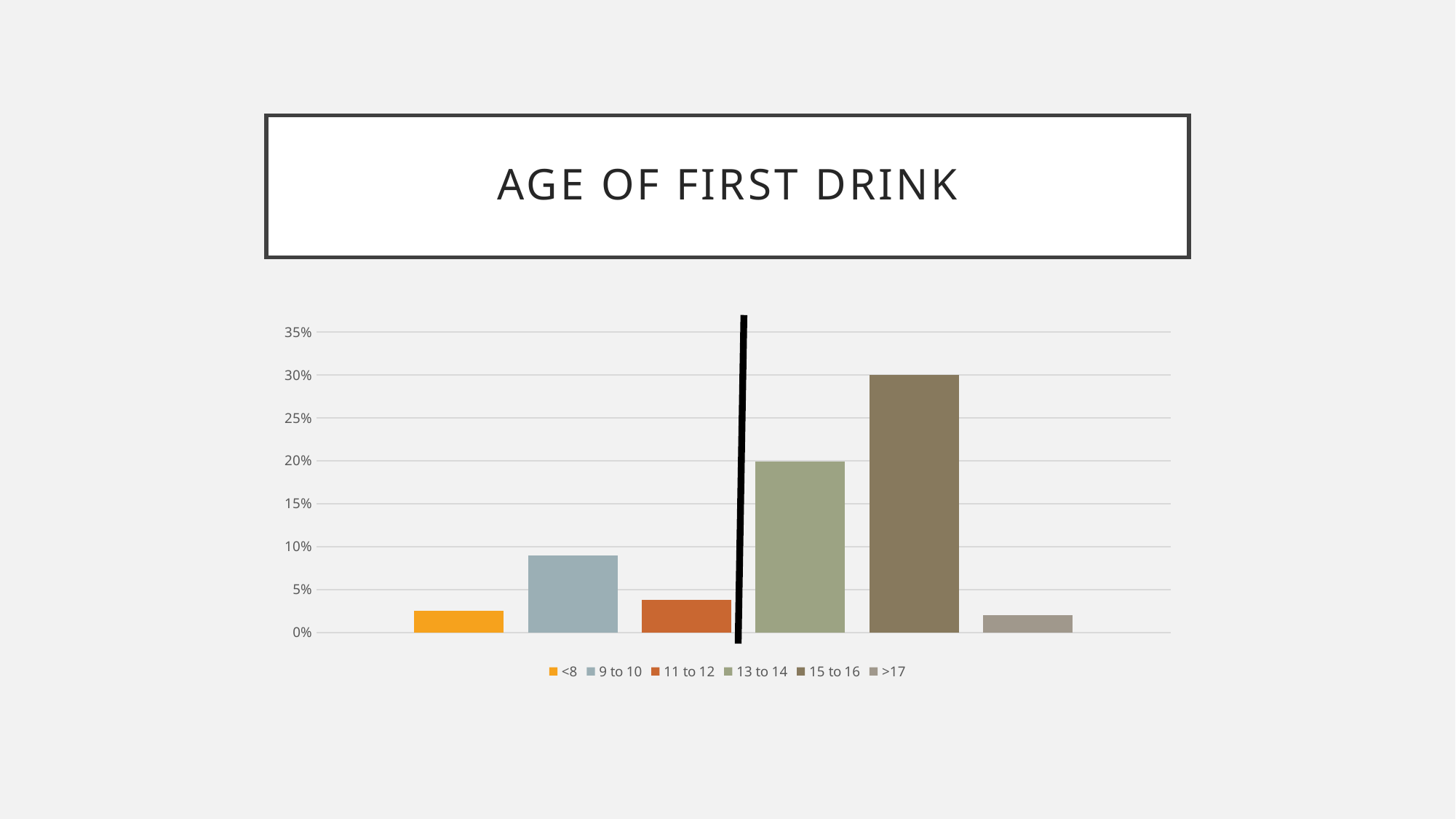
How many bars are plotted in the chart? 6 Is the value for 11 to 12 greater or less than 5%? less What kind of chart is shown on the slide? bar chart Is the value for 9 to 10 greater or less than 5%? greater Which is larger, the value for 9 to 10 or the value for 11 to 12? 9 to 10 What is the value for the 15 to 16 age group? 30% What is the title of the chart? Age of First Drink How many series does the legend list? 6 Which age group has the highest value? 15 to 16 Is the value for 9 to 10 greater or less than 10%? less